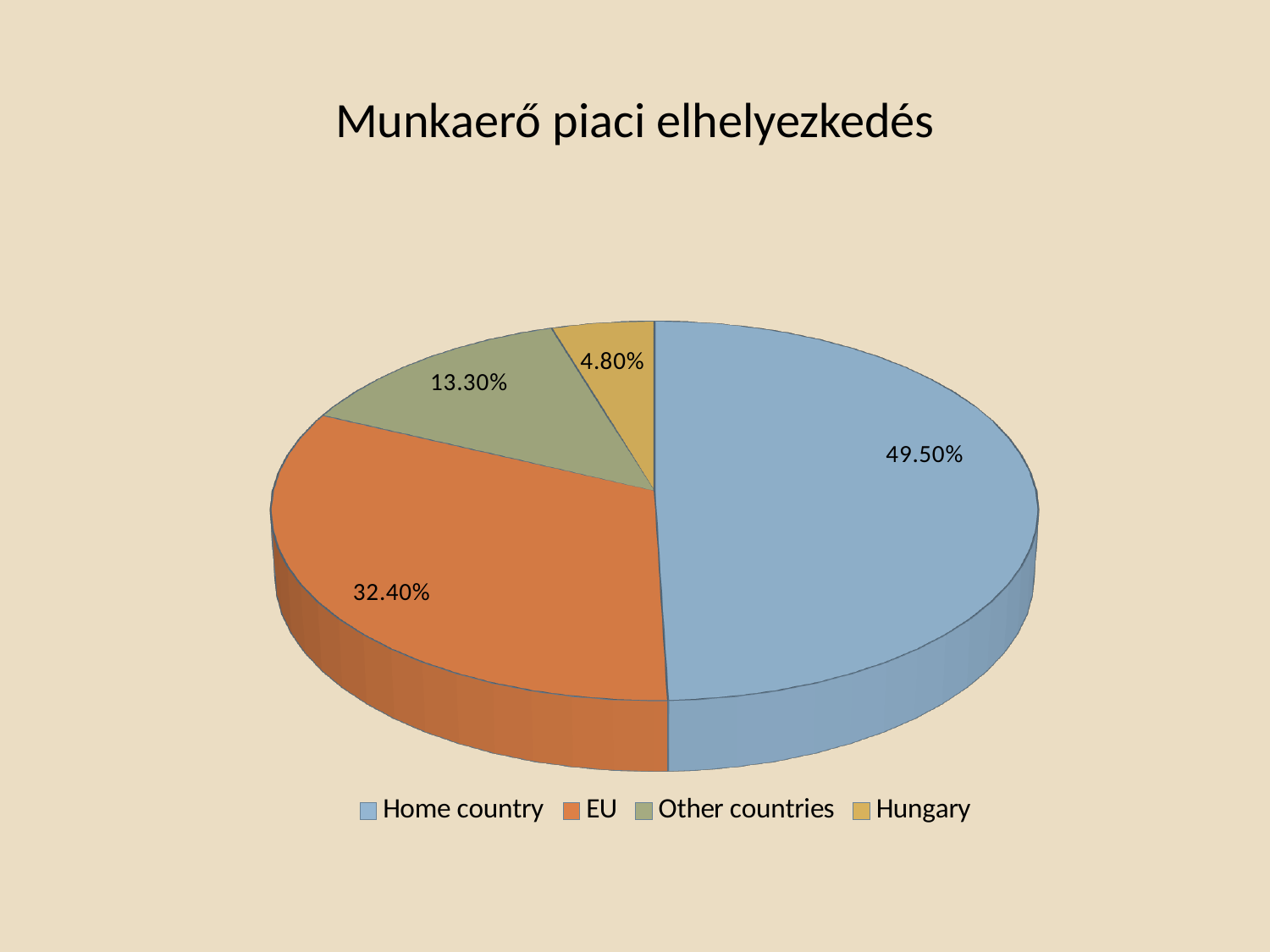
What share of the pie does EU have? 32.40% What share of the pie does Other countries have? 13.30% How many categories does the pie chart show? 4 Which colour represents EU in the legend? Orange What is the title of the chart? Munkaerő piaci elhelyezkedés Which category has the smallest slice of the pie? Hungary What share of the pie does Home country have? 49.50% Which is larger, the share for Other countries or the share for Hungary? Other countries What is the difference in percentage points between Home country and EU? 17.10 What share of the pie does Hungary have? 4.80% Which category has the largest slice of the pie? Home country What type of chart is shown on the slide? Pie chart